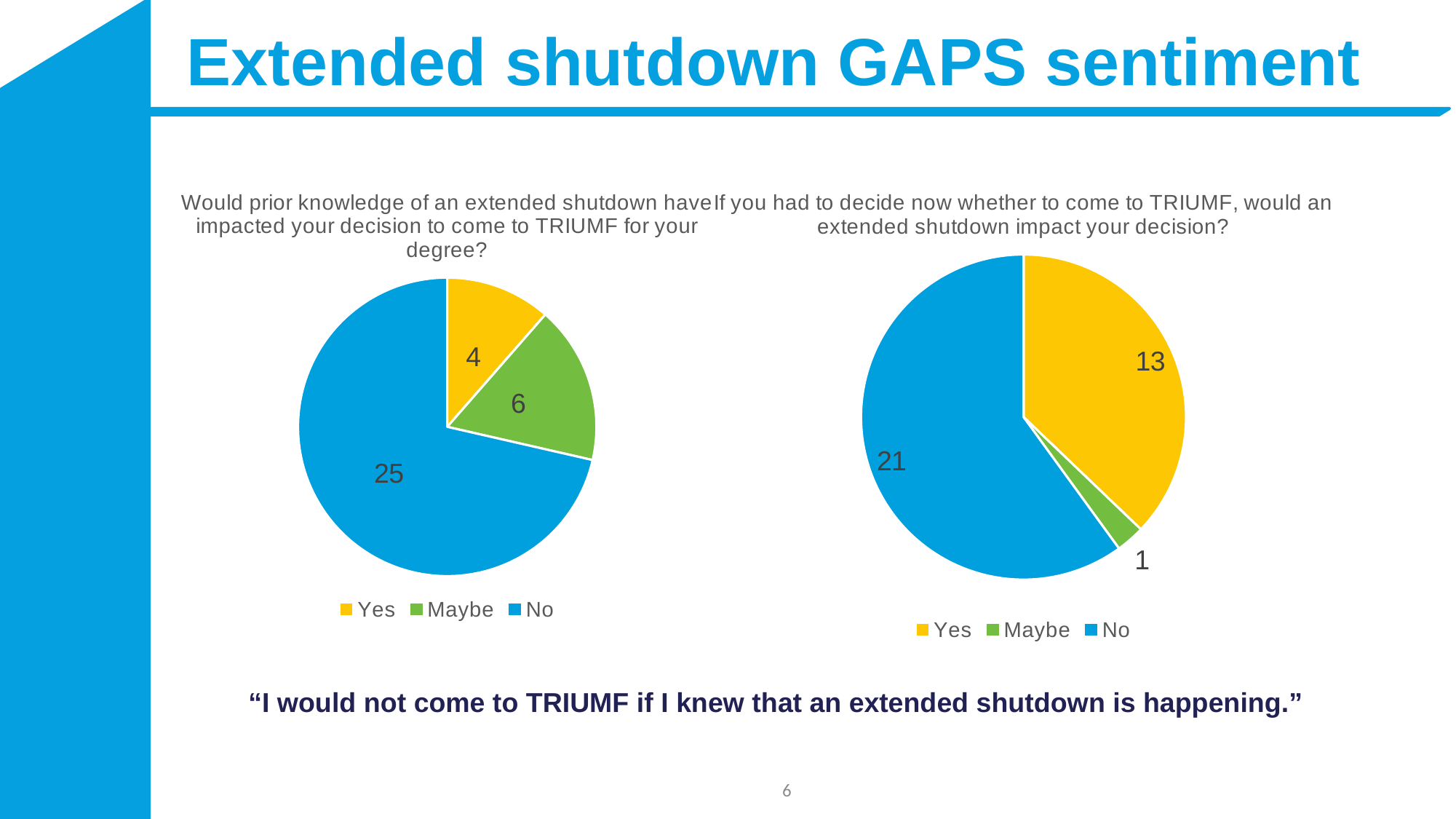
In the right pie chart, which response has the smallest slice? Maybe In the left pie chart, what is the difference between the "No" and "Yes" values? 21 In the right pie chart (decide now whether to come to TRIUMF), what is the value for "Yes"? 13 In the left pie chart (prior knowledge of an extended shutdown), what is the value for "Maybe"? 6 In the left pie chart, what colour represents the "Maybe" response? Green In the right pie chart, what is the difference between the "No" and "Yes" values? 8 What type of chart is used on the right side of the slide? Pie chart In the right pie chart (decide now whether to come to TRIUMF), what is the value for "Maybe"? 1 In the left pie chart, which response has the largest slice? No In the left pie chart (prior knowledge of an extended shutdown), what is the value for "No"? 25 How many categories does the legend of the left pie chart list? 3 Which is larger in the right pie chart: the "Yes" value or the "Maybe" value? Yes